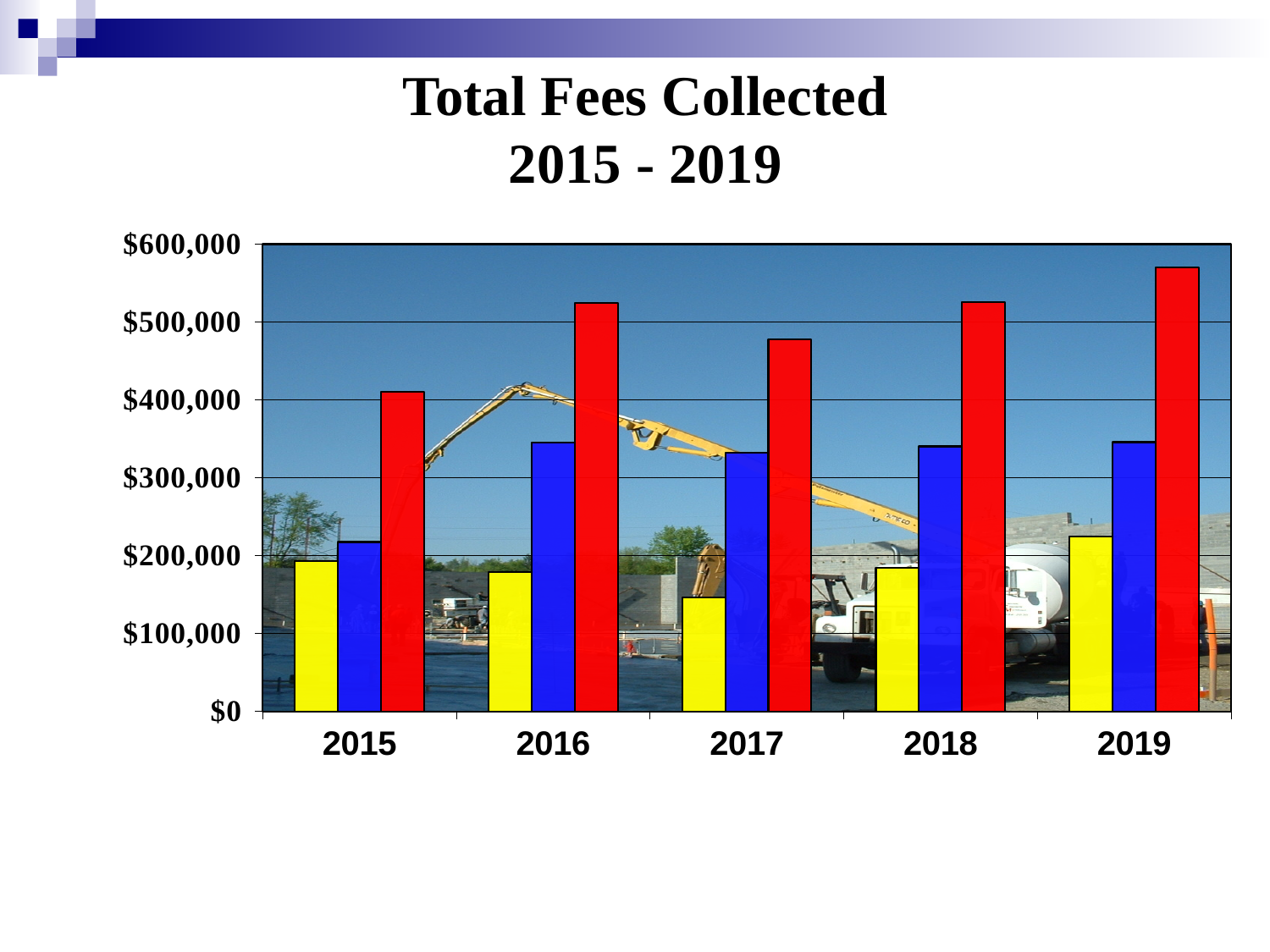
Is the value of the yellow bar for 2017 greater or less than $200,000? less How many bars are plotted for each year in the chart? 3 Is the value of the blue bar for 2015 greater or less than $300,000? less Is the value of the red bar for 2019 greater or less than $500,000? greater What is the title of the chart? Total Fees Collected 2015 - 2019 In which year is the yellow bar the shortest? 2017 In which year is the yellow bar the tallest? 2019 In which year is the red bar the shortest? 2015 Which year has the larger red bar, 2016 or 2017? 2016 How many years are shown along the x axis of the chart? 5 What type of chart is shown on the slide? Bar chart In which year is the red bar the tallest? 2019